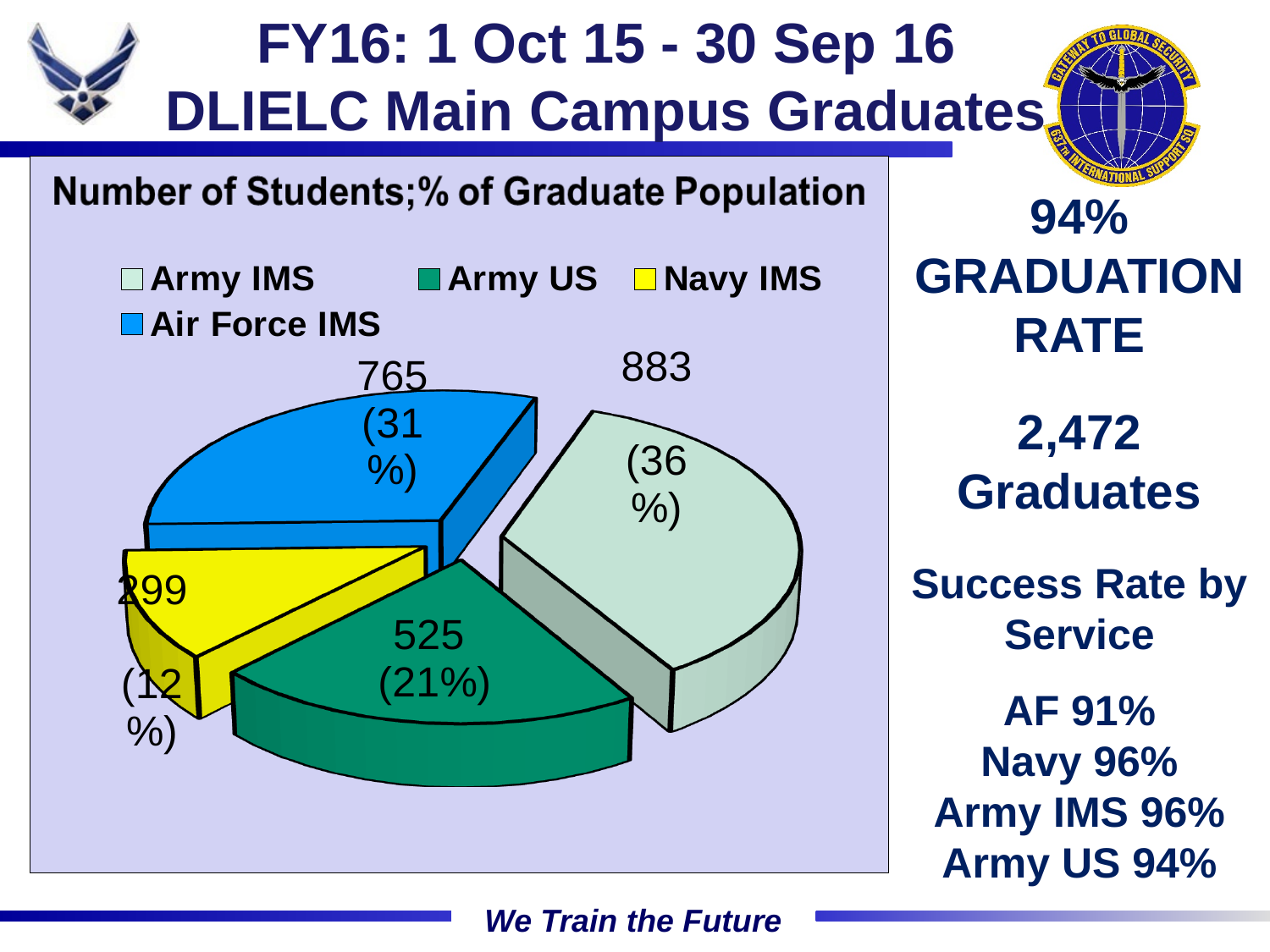
How many entries does the legend of the pie chart list? 4 What percentage of the graduate population does the Air Force IMS slice represent? 31% What is the difference in number of students between Army IMS and Army US? 358 Which category has the smallest slice in the pie chart? Navy IMS What is the number of students for Army IMS in the pie chart? 883 What percentage of the graduate population does the Navy IMS slice represent? 12% Which category has the largest slice in the pie chart? Army IMS What is the number of students for Army US in the pie chart? 525 What is the number of students for Air Force IMS in the pie chart? 765 What percentage of the graduate population does the Army IMS slice represent? 36% What kind of chart is shown on the slide? Pie chart How many slices does the pie chart have? 4